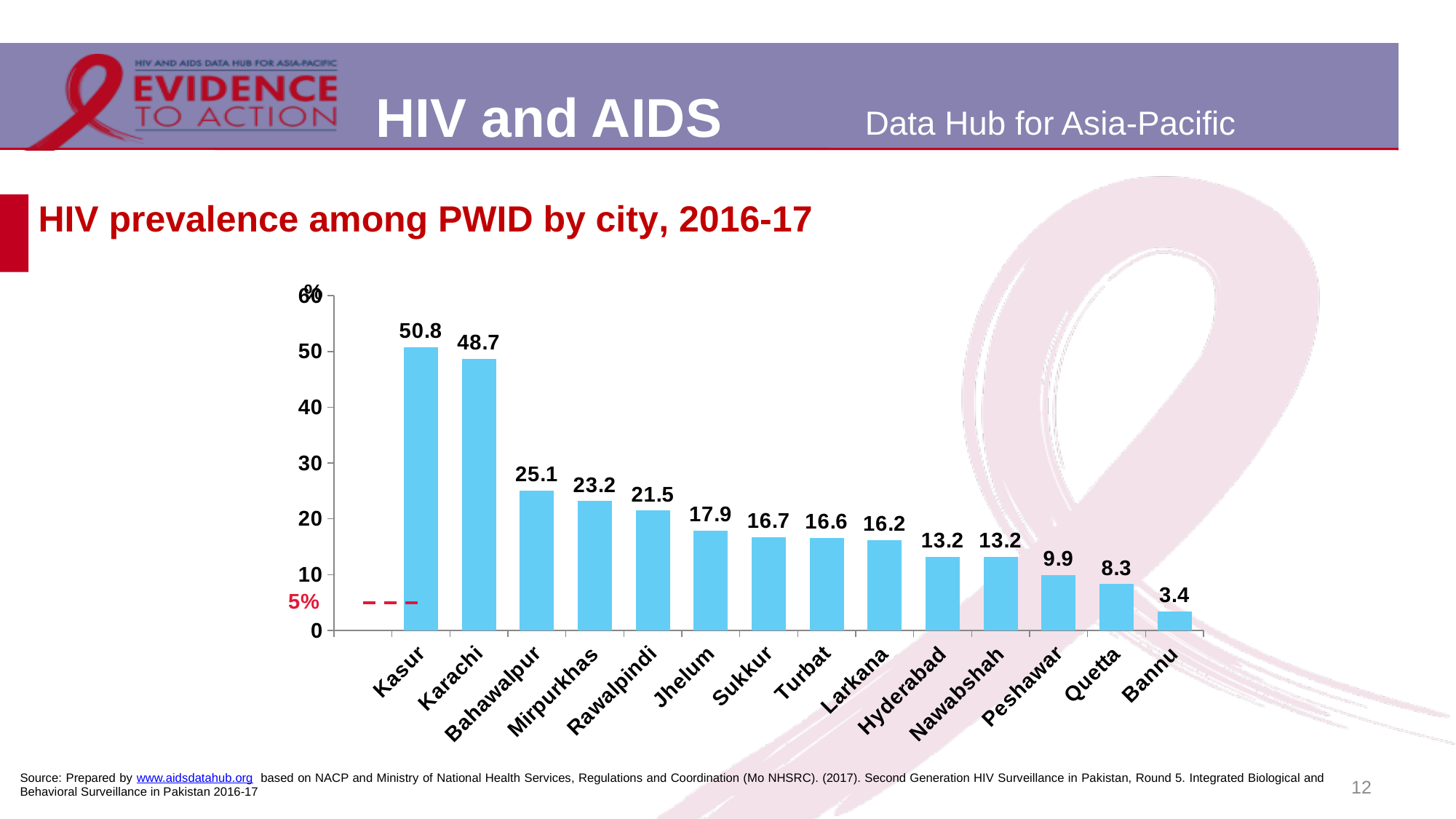
What is the difference in HIV prevalence between Kasur and Karachi? 2.1 What is the HIV prevalence among PWID in Peshawar? 9.9 What is the HIV prevalence among PWID in Karachi? 48.7 What value does the red dashed reference line on the chart mark? 5% How many cities are shown in the chart? 14 Which city has the lowest HIV prevalence among PWID? Bannu Do the values rise or fall from left to right across the cities? Fall What is the HIV prevalence among PWID in Rawalpindi? 21.5 Which city has the highest HIV prevalence among PWID? Kasur What type of chart is used on the slide? Bar chart What is the difference in HIV prevalence between Bahawalpur and Quetta? 16.8 Which city has a higher HIV prevalence among PWID, Jhelum or Larkana? Jhelum